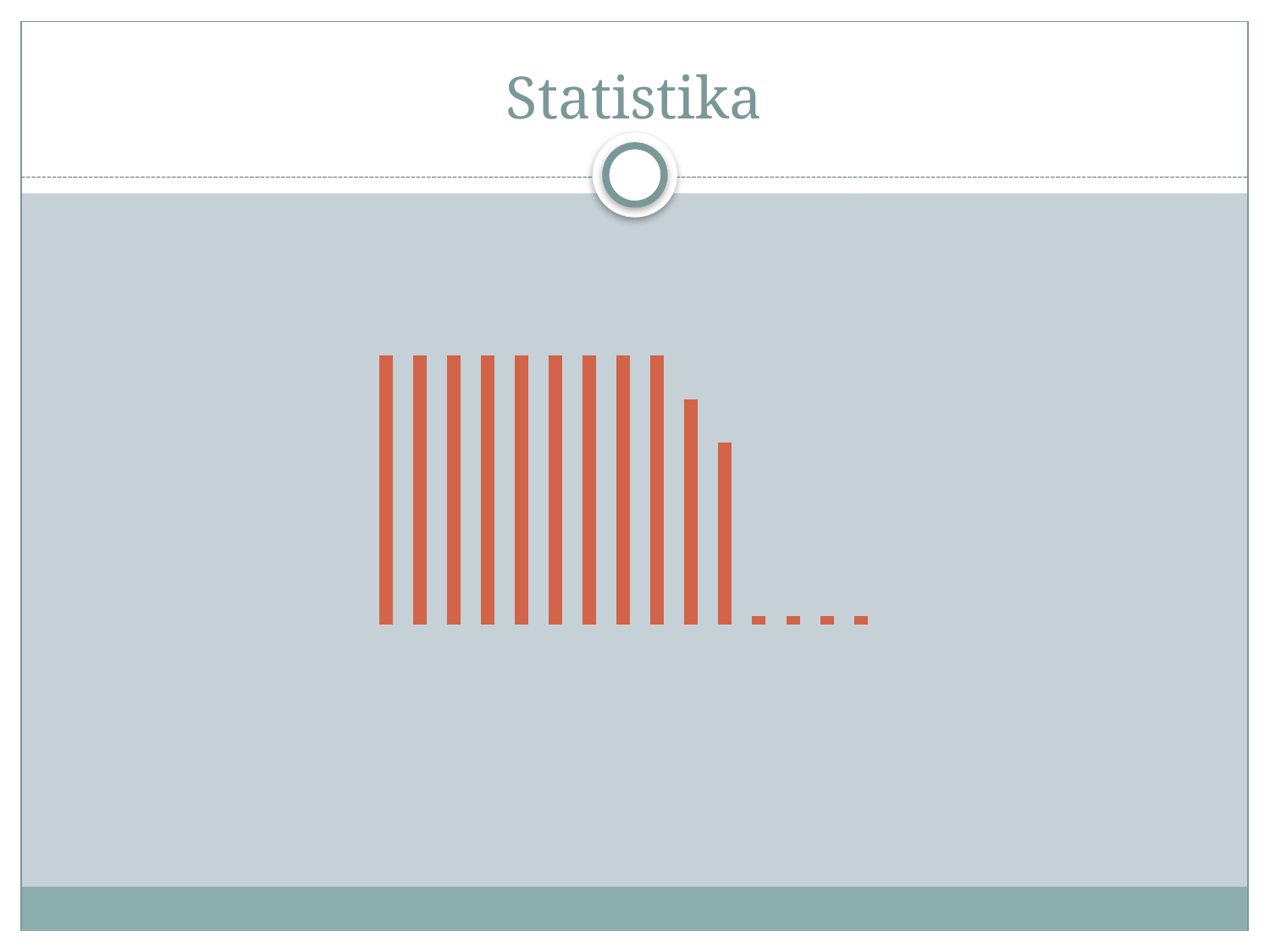
What colour are the bars in the chart? orange Do the bar values rise or fall from left to right along the x axis? fall Does the chart display a legend? no How many bars does the chart contain? 15 What kind of chart is shown on the slide? bar chart How many bars share the tallest height in the chart? 9